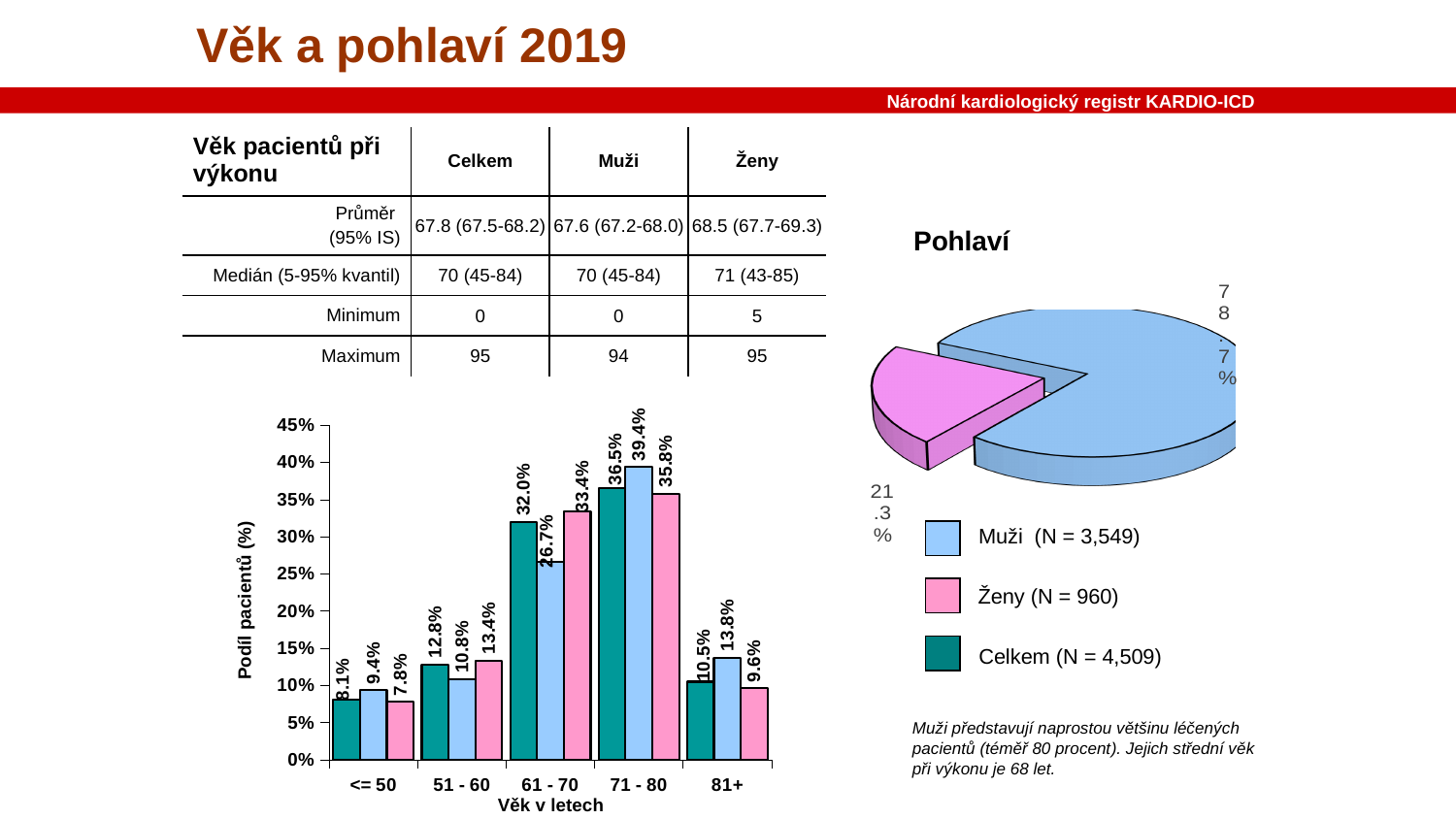
How many series does the legend next to the pie chart list? 3 In the bar chart, which age group has the highest value for Celkem? 71 - 80 In the pie chart titled Pohlaví, what is the N value shown in the legend for Ženy? 960 How many age groups are shown on the x axis of the bar chart? 5 In the bar chart, what is the value for Celkem in the <= 50 age group? 8.1% In the pie chart titled Pohlaví, what share of the pie is Muži? 78.7% What kind of chart is the chart titled Pohlaví? Pie chart In the bar chart, what is the value for Ženy in the 61 - 70 age group? 33.4% In the bar chart, what is the value for Muži in the 71 - 80 age group? 39.4% In the bar chart, which is larger in the 61 - 70 age group: the value for Muži or the value for Ženy? Ženy In the bar chart, what is the difference between the Muži and Ženy values in the 81+ age group? 4.2% In the bar chart, which age group has the lowest value for Ženy? <= 50